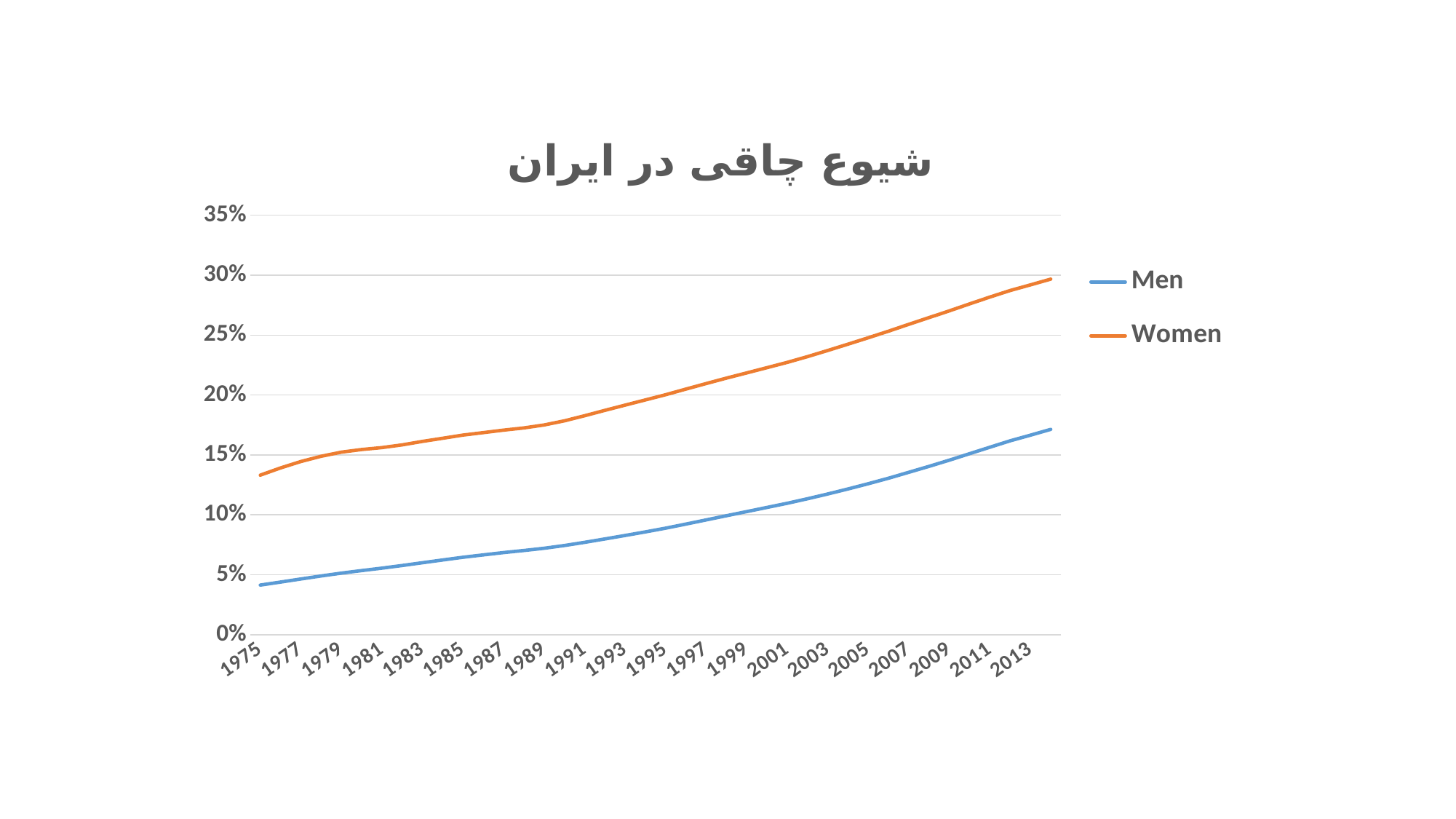
Is the value for Men in 2013 greater or less than 15%? greater Which series has the lower value in 1975, Men or Women? Men What kind of chart is shown on the slide? line chart What colour is the line for Women? orange Is the value for Women in 1975 greater or less than 15%? less Do the values for Women rise or fall from 1975 to 2013? rise Which series has the higher value in 2013, Men or Women? Women Which series does the legend list besides Men? Women Is the value for Men in 1975 greater or less than 5%? less How many series does the legend list? 2 Do the values for Men rise or fall from 1975 to 2013? rise